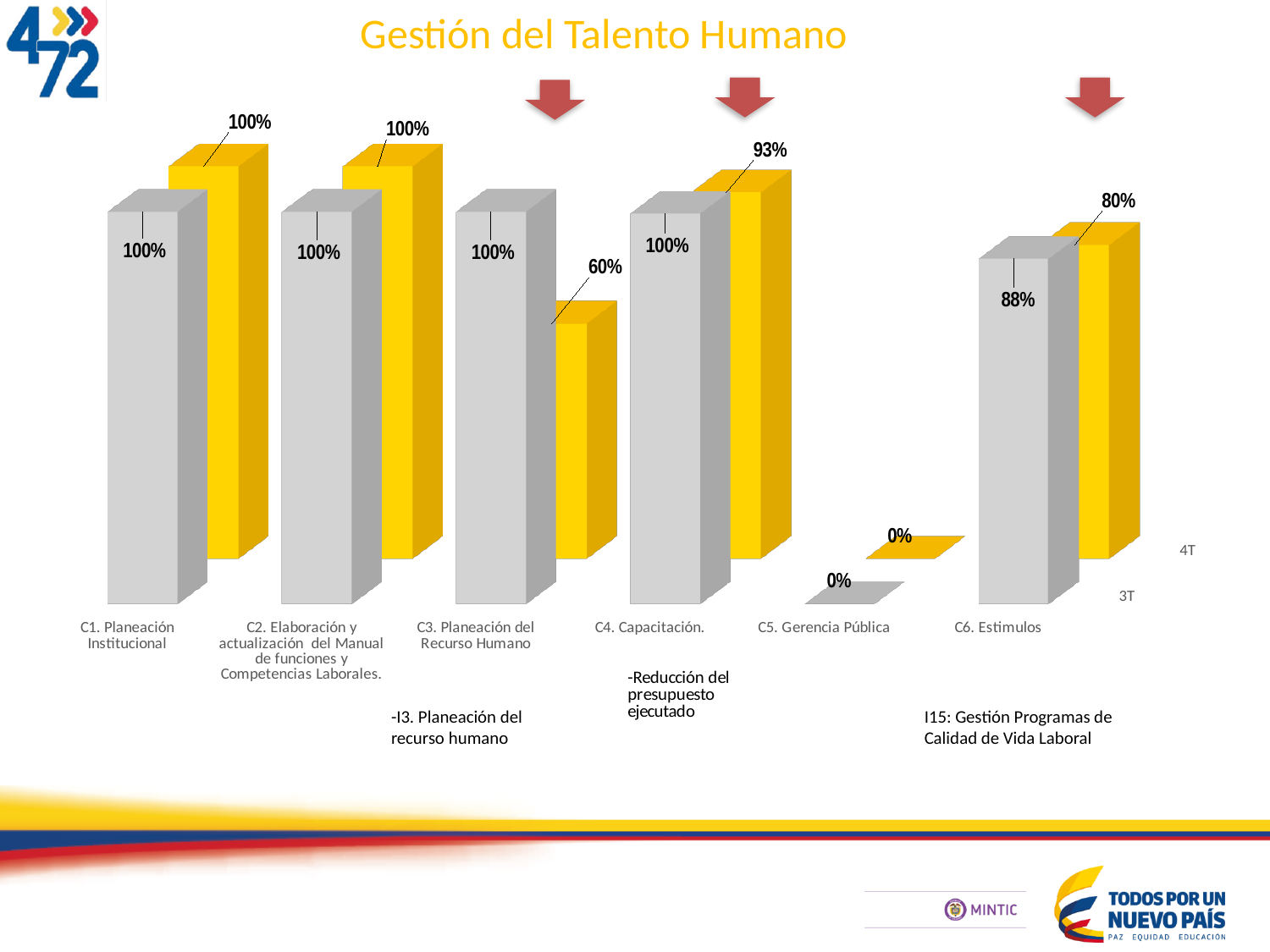
What is the difference between the 3T and 4T values for C6. Estimulos? 8% What is the title of the slide containing the chart? Gestión del Talento Humano What is the 4T value for C3. Planeación del Recurso Humano? 60% What is the difference between the 3T and 4T values for C3. Planeación del Recurso Humano? 40% How many data series does the chart show? 2 Which category has the lowest 4T value? C5. Gerencia Pública What is the 4T value for C6. Estimulos? 80% What type of chart is shown on the slide? Bar chart What is the 4T value for C4. Capacitación? 93% What is the 3T value for C6. Estimulos? 88% Which is larger for C4. Capacitación, the 3T value or the 4T value? 3T How many categories are shown on the chart? 6